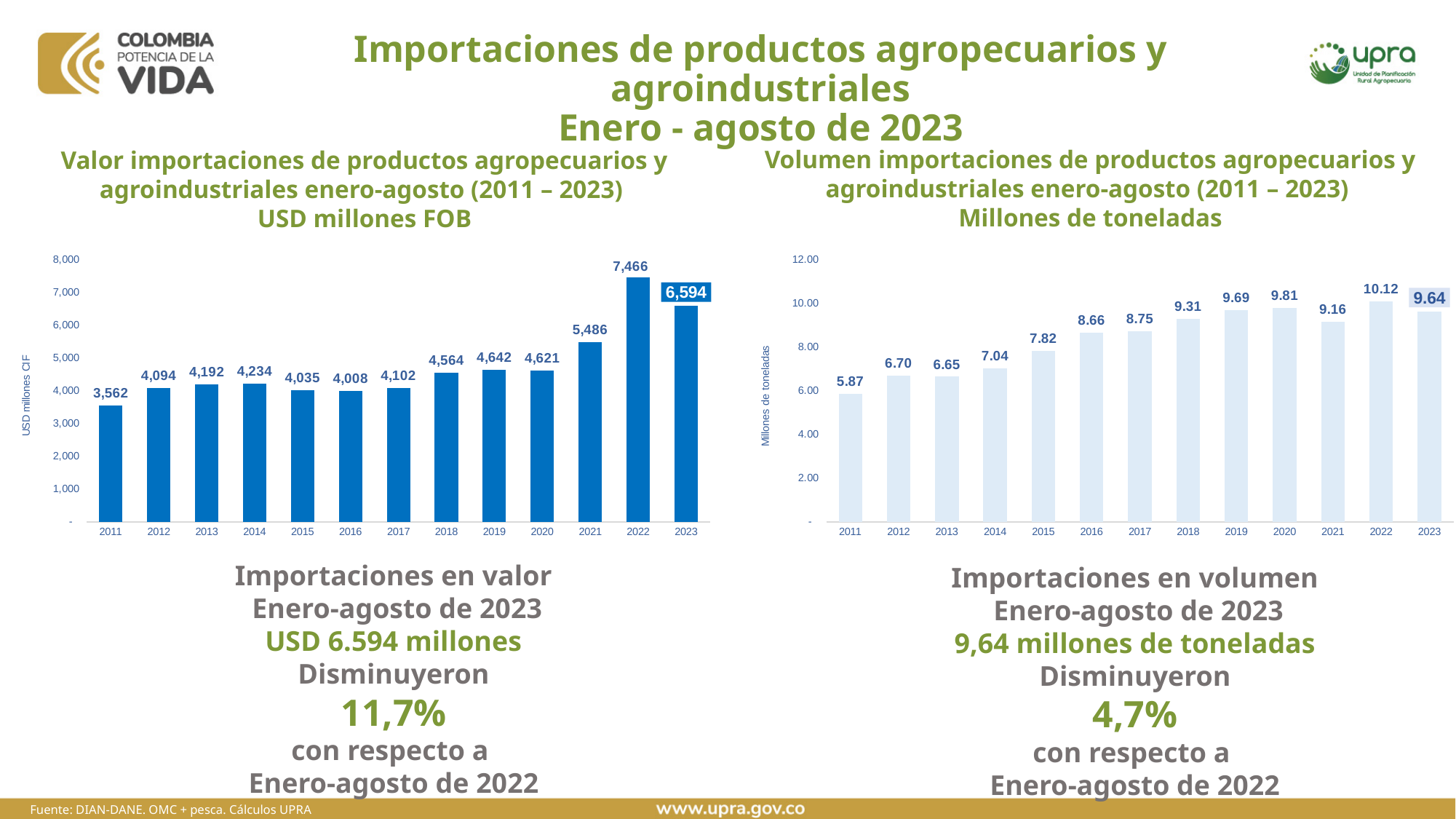
In the right chart (Volumen importaciones, Millones de toneladas), which is larger, the value for 2020 or the value for 2021? 2020 In the left chart (Valor importaciones, USD millones FOB), how many years are plotted? 13 In the right chart (Volumen importaciones, Millones de toneladas), what is the value for 2011? 5.87 What is the y-axis label of the right chart (Volumen importaciones)? Millones de toneladas In the left chart (Valor importaciones, USD millones FOB), which year has the lowest value? 2011 What type of chart is the left chart (Valor importaciones, USD millones FOB)? Bar chart In the right chart (Volumen importaciones, Millones de toneladas), is the value for 2015 greater or less than 8.00? less In the right chart (Volumen importaciones, Millones de toneladas), which year has the highest value? 2022 In the left chart (Valor importaciones, USD millones FOB), what is the difference between the 2022 and 2023 values? 872 In the right chart (Volumen importaciones, Millones de toneladas), what is the difference between the 2022 and 2023 values? 0.48 In the left chart (Valor importaciones, USD millones FOB), what is the value for 2023? 6,594 In the left chart (Valor importaciones, USD millones FOB), which year has the highest value? 2022